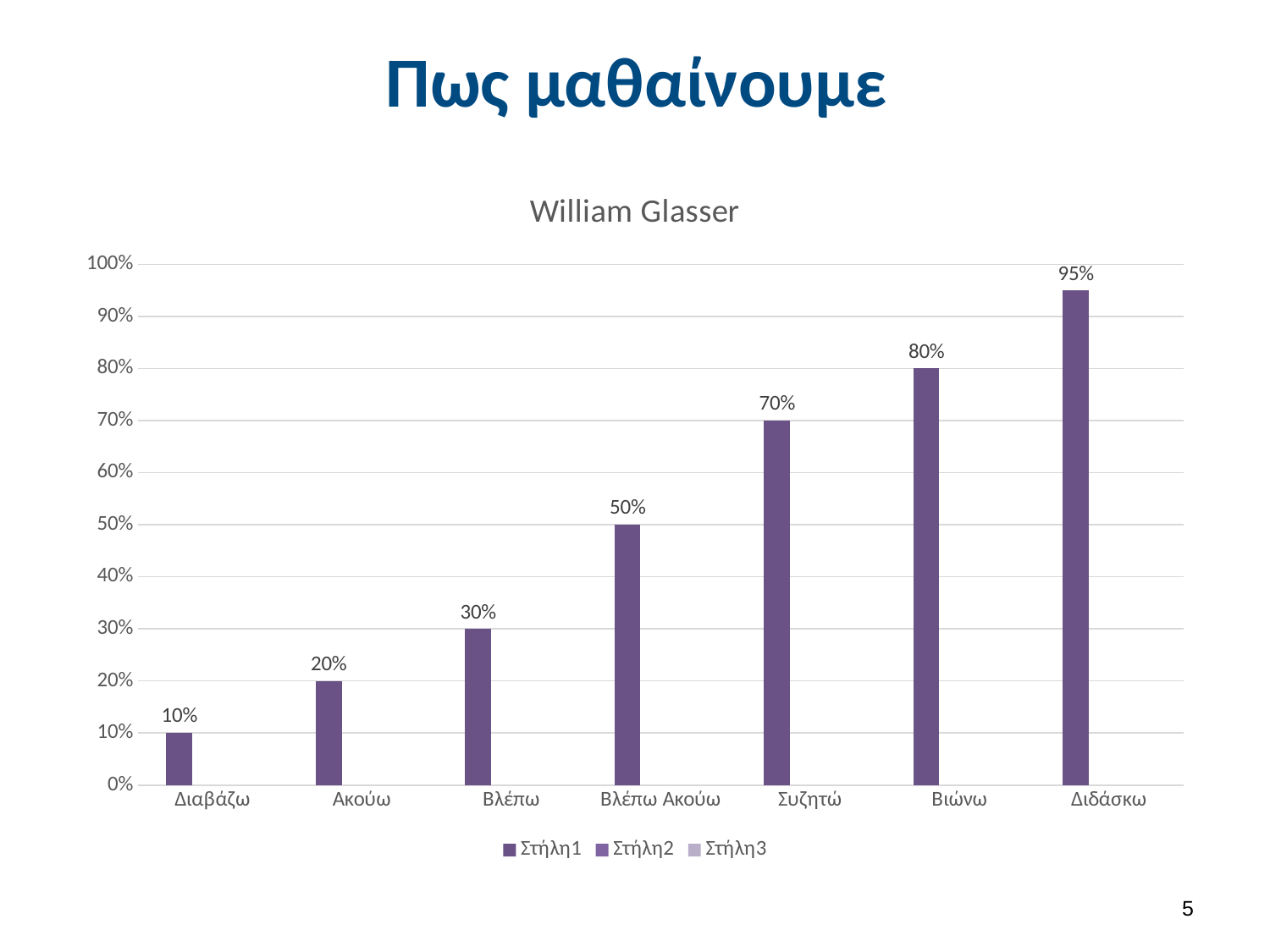
What is the value for Διδάσκω? 95% What is the difference between the values for Βιώνω and Βλέπω Ακούω? 30% Do the values rise or fall from left to right along the x axis? Rise How many categories are shown on the x axis? 7 Which category has the lowest value? Διαβάζω How many series does the legend list? 3 What is the value for Διαβάζω? 10% Which category has the highest value? Διδάσκω Which is larger, the value for Ακούω or the value for Βλέπω? Βλέπω What is the title of the chart? William Glasser What kind of chart is shown? Bar chart What is the value for Συζητώ? 70%